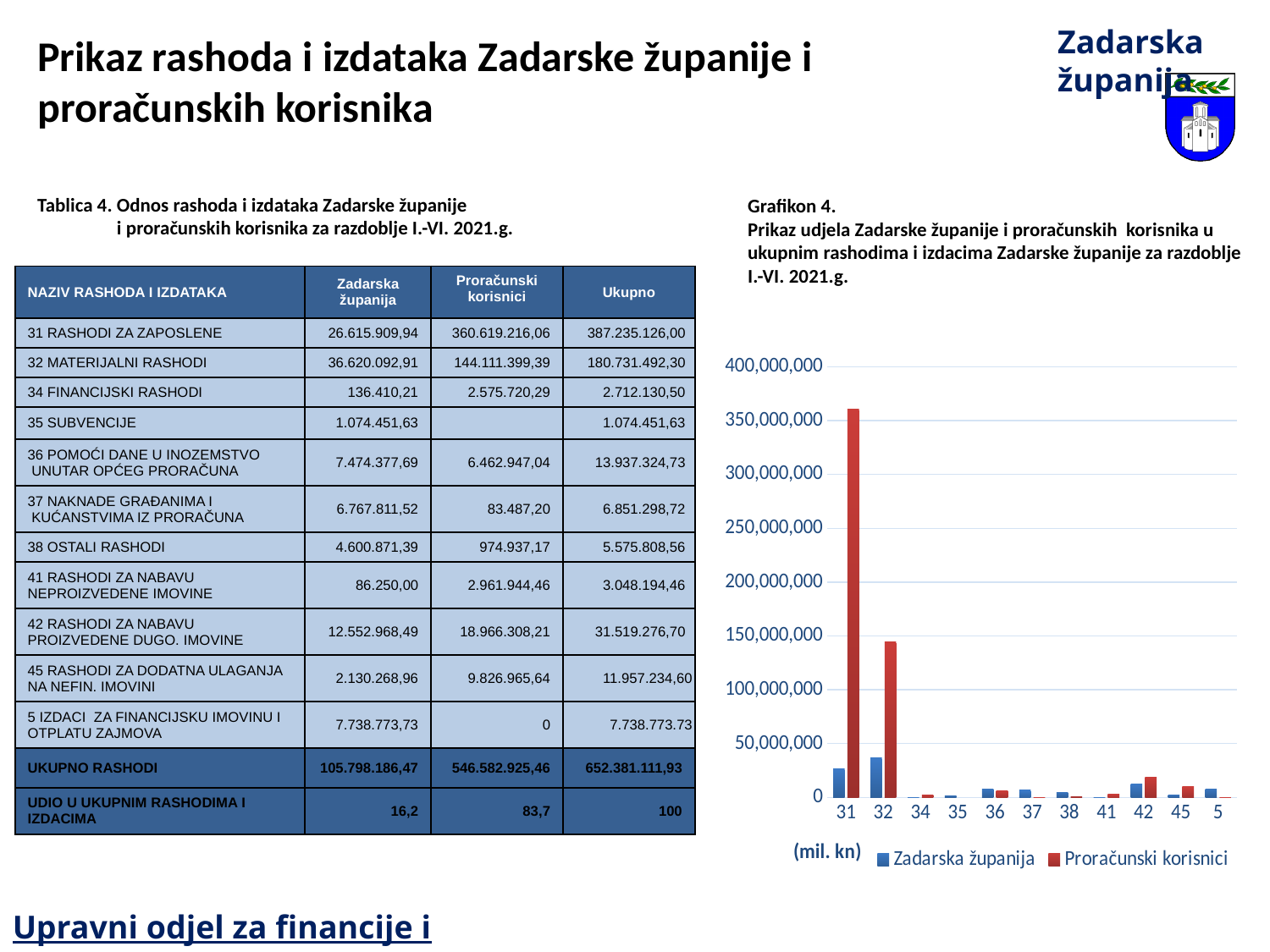
In Grafikon 4, is the value for Proračunski korisnici at category 32 greater or less than 100,000,000? greater What are the two legend entries in Grafikon 4? Zadarska županija and Proračunski korisnici How many categories are shown on the x axis of Grafikon 4? 11 In Grafikon 4, which category has the highest value for Zadarska županija? 32 In Grafikon 4, is the value for Proračunski korisnici at category 31 greater or less than 350,000,000? greater How many series does the legend of Grafikon 4 list? 2 In Grafikon 4, at category 45, which series has the larger value: Zadarska županija or Proračunski korisnici? Proračunski korisnici In Grafikon 4, is the value for Zadarska županija at category 31 greater or less than 50,000,000? less In Grafikon 4, at category 31, which series has the larger value: Zadarska županija or Proračunski korisnici? Proračunski korisnici What kind of chart is Grafikon 4? bar chart In Grafikon 4, which category has the highest value for Proračunski korisnici? 31 In Grafikon 4, at category 5, which series has the larger value: Zadarska županija or Proračunski korisnici? Zadarska županija